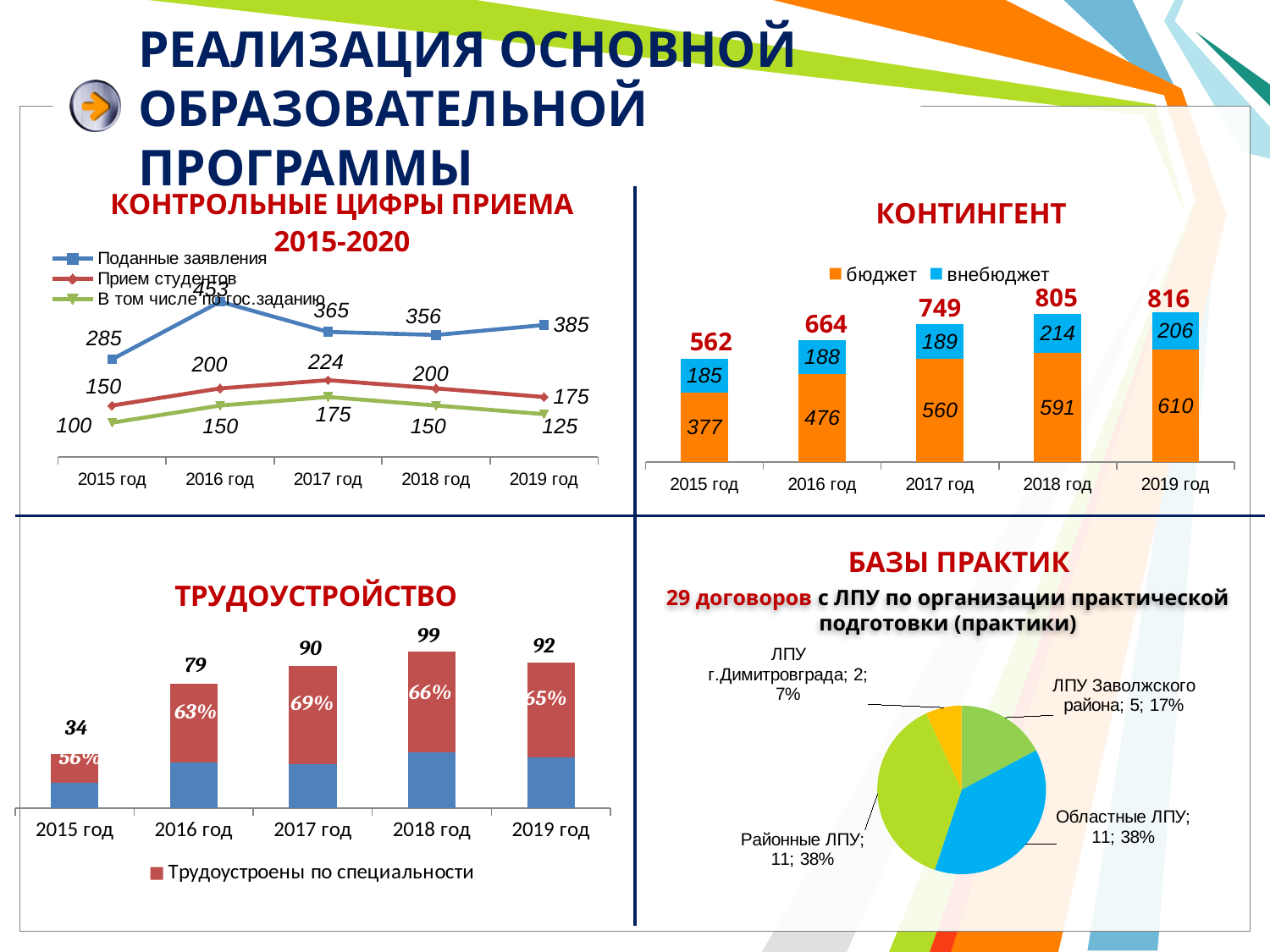
In the 'БАЗЫ ПРАКТИК' pie chart, how many slices are there? 4 In the 'КОНТИНГЕНТ' chart, what is the total of the stacked bar for 2018 год? 805 In the 'КОНТРОЛЬНЫЕ ЦИФРЫ ПРИЕМА 2015-2020' chart, which year has the highest value for 'Прием студентов'? 2017 год In the 'КОНТИНГЕНТ' chart, what is the 'бюджет' value for 2017 год? 560 In the 'БАЗЫ ПРАКТИК' pie chart, what share does 'ЛПУ Заволжского района' have? 17% In the 'КОНТИНГЕНТ' chart, does the 'бюджет' value rise or fall from 2015 год to 2019 год? Rise In the 'КОНТРОЛЬНЫЕ ЦИФРЫ ПРИЕМА 2015-2020' chart, what is the value of 'Поданные заявления' for 2016 год? 453 What kind of chart is 'КОНТРОЛЬНЫЕ ЦИФРЫ ПРИЕМА 2015-2020'? Line chart In the 'КОНТРОЛЬНЫЕ ЦИФРЫ ПРИЕМА 2015-2020' chart, what is the difference between 'Поданные заявления' and 'Прием студентов' in 2019 год? 210 In the 'ТРУДОУСТРОЙСТВО' chart, which year has the lowest total value? 2015 год In the 'КОНТРОЛЬНЫЕ ЦИФРЫ ПРИЕМА 2015-2020' chart, how many series does the legend list? 3 In the 'ТРУДОУСТРОЙСТВО' chart, what percentage is shown for 'Трудоустроены по специальности' in 2017 год? 69%